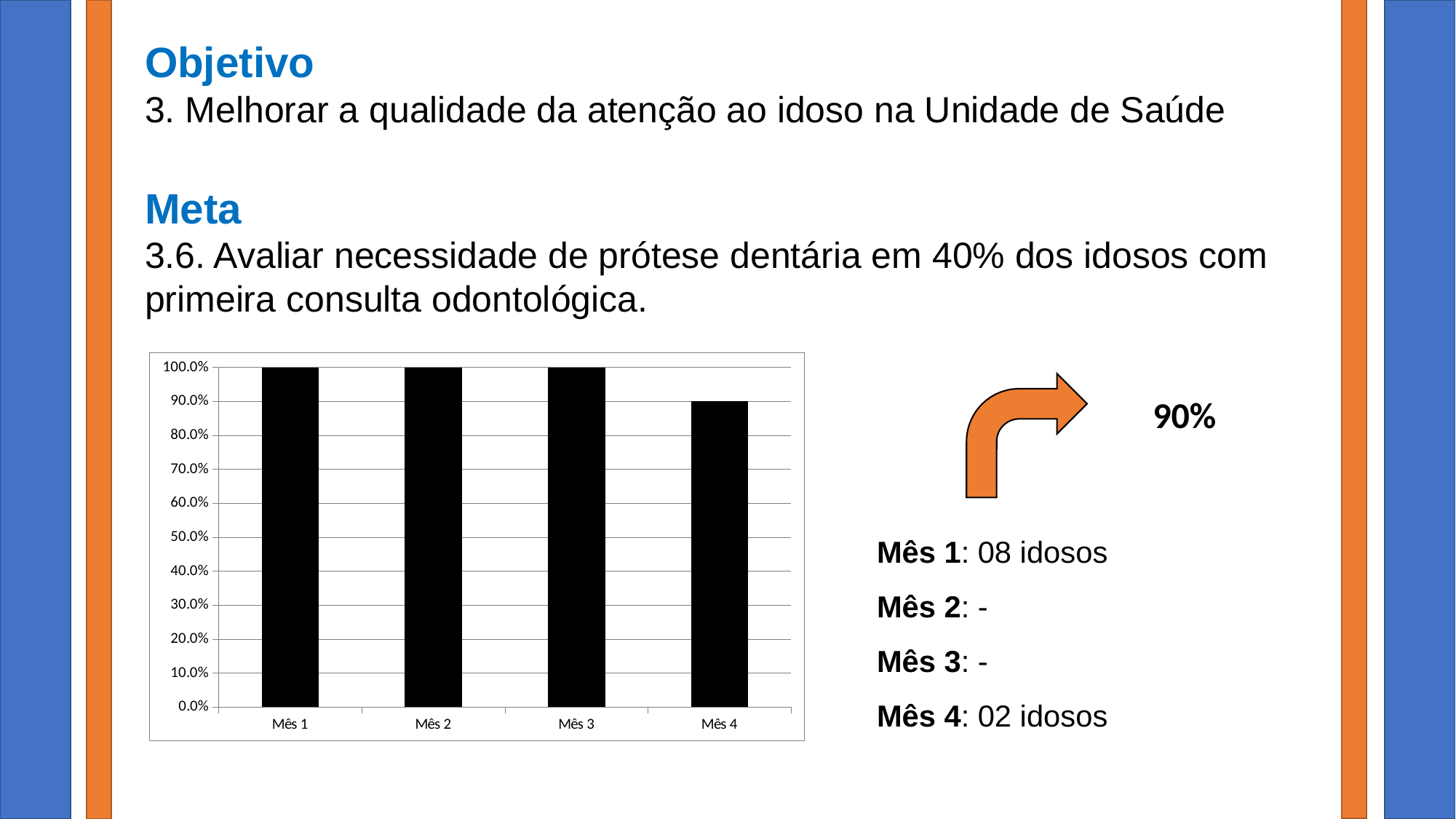
What colour are the bars in the chart? black Which is larger in the chart, the value for Mês 2 or the value for Mês 4? Mês 2 What is the difference between the value for Mês 1 and the value for Mês 4 in the chart? 10.0% Do the values in the chart rise or fall from Mês 3 to Mês 4? fall What kind of chart is shown on the slide? bar chart Which category has the lowest value in the chart? Mês 4 What is the value for Mês 4 in the chart? 90.0% Is the value for Mês 4 greater or less than 50.0%? greater What is the highest tick shown on the y axis of the chart? 100.0% How many categories are plotted on the x axis of the chart? 4 What is the value for Mês 1 in the chart? 100.0% What is the value for Mês 3 in the chart? 100.0%